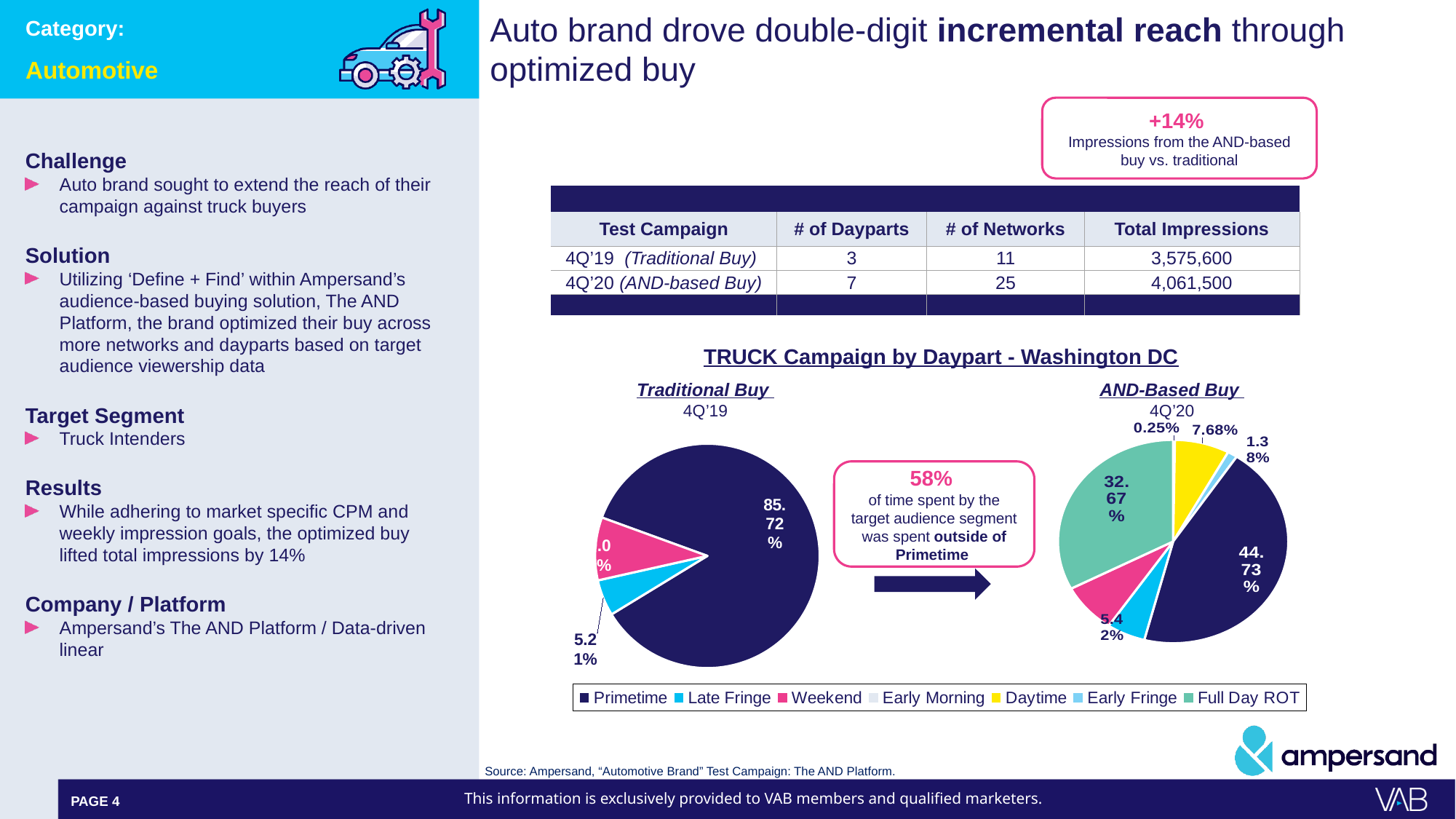
In the AND-Based Buy 4Q'20 pie chart, what share is Primetime? 44.73% In the Traditional Buy 4Q'19 pie chart, what share is Primetime? 85.72% What kind of chart is used to show the Traditional Buy 4Q'19 daypart breakdown? Pie chart By how many percentage points is the Primetime share in the Traditional Buy 4Q'19 pie chart larger than in the AND-Based Buy 4Q'20 pie chart? 40.99 percentage points In the AND-Based Buy 4Q'20 pie chart, what share is Full Day ROT? 32.67% In the AND-Based Buy 4Q'20 pie chart, which daypart has the smallest share? Early Morning In the Traditional Buy 4Q'19 pie chart, what share is Late Fringe? 5.21% In the AND-Based Buy 4Q'20 pie chart, what share is Daytime? 7.68% In the AND-Based Buy 4Q'20 pie chart, which is larger: Full Day ROT or Daytime? Full Day ROT In the AND-Based Buy 4Q'20 pie chart, which daypart has the largest share? Primetime How many daypart categories does the shared legend below the pie charts list? 7 In the AND-Based Buy 4Q'20 pie chart, what share is Early Morning? 0.25%